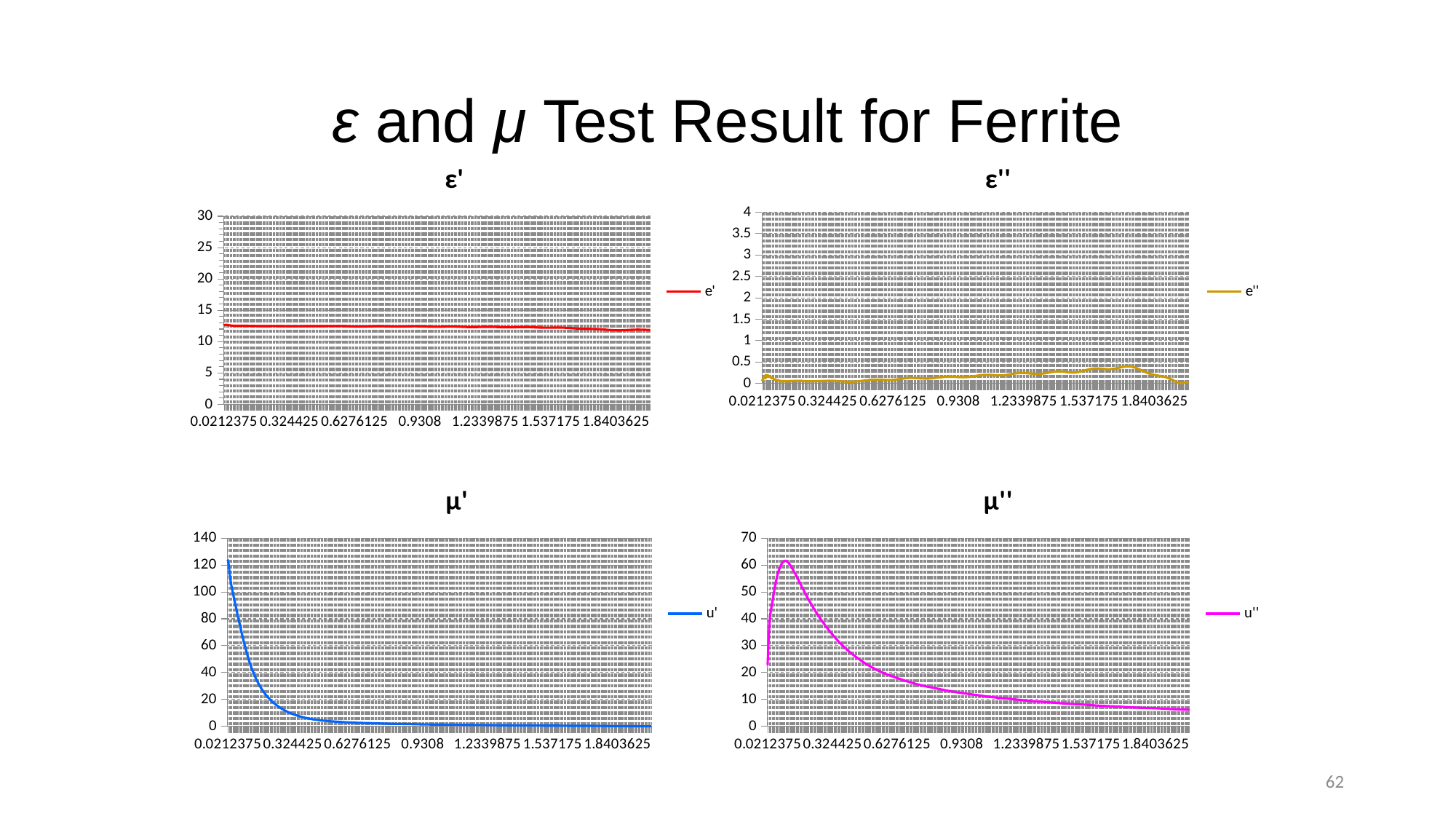
In the chart titled ε'', is the value at 0.9308 greater or less than 1? less In the chart titled μ'', is the value at 1.8403625 greater or less than 20? less What kind of chart is the chart titled μ'? line chart In the chart titled ε', how many series does the legend list? 1 In the chart titled μ'', what is the legend entry for the plotted series? u'' In the chart titled μ'', is the peak value of the series greater or less than 50? greater In the chart titled ε'', what is the legend entry for the plotted series? e'' In the chart titled μ', do the values rise or fall along the x axis? fall How many charts are shown on the slide? 4